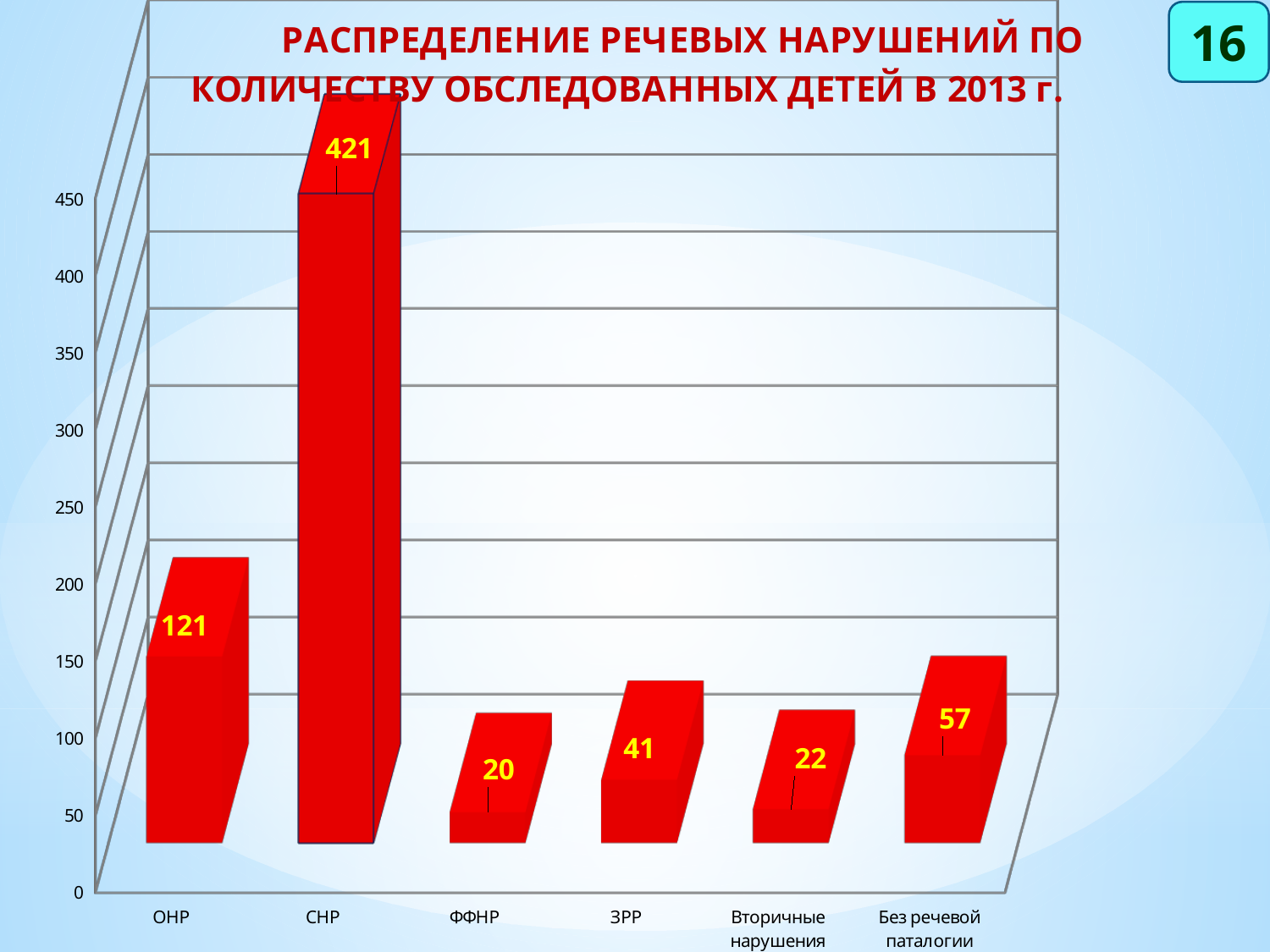
Which category has the lowest value? ФФНР What is the value for Без речевой паталогии? 57 How many categories are shown on the x axis? 6 Which category has the highest value? СНР What year is mentioned in the chart title? 2013 What is the value for СНР? 421 What is the value for ОНР? 121 What is the value for Вторичные нарушения? 22 What is the difference between the values for Без речевой паталогии and ЗРР? 16 What kind of chart is shown on the slide? Bar chart Which is larger, the value for ЗРР or the value for ФФНР? ЗРР What is the difference between the values for СНР and ОНР? 300